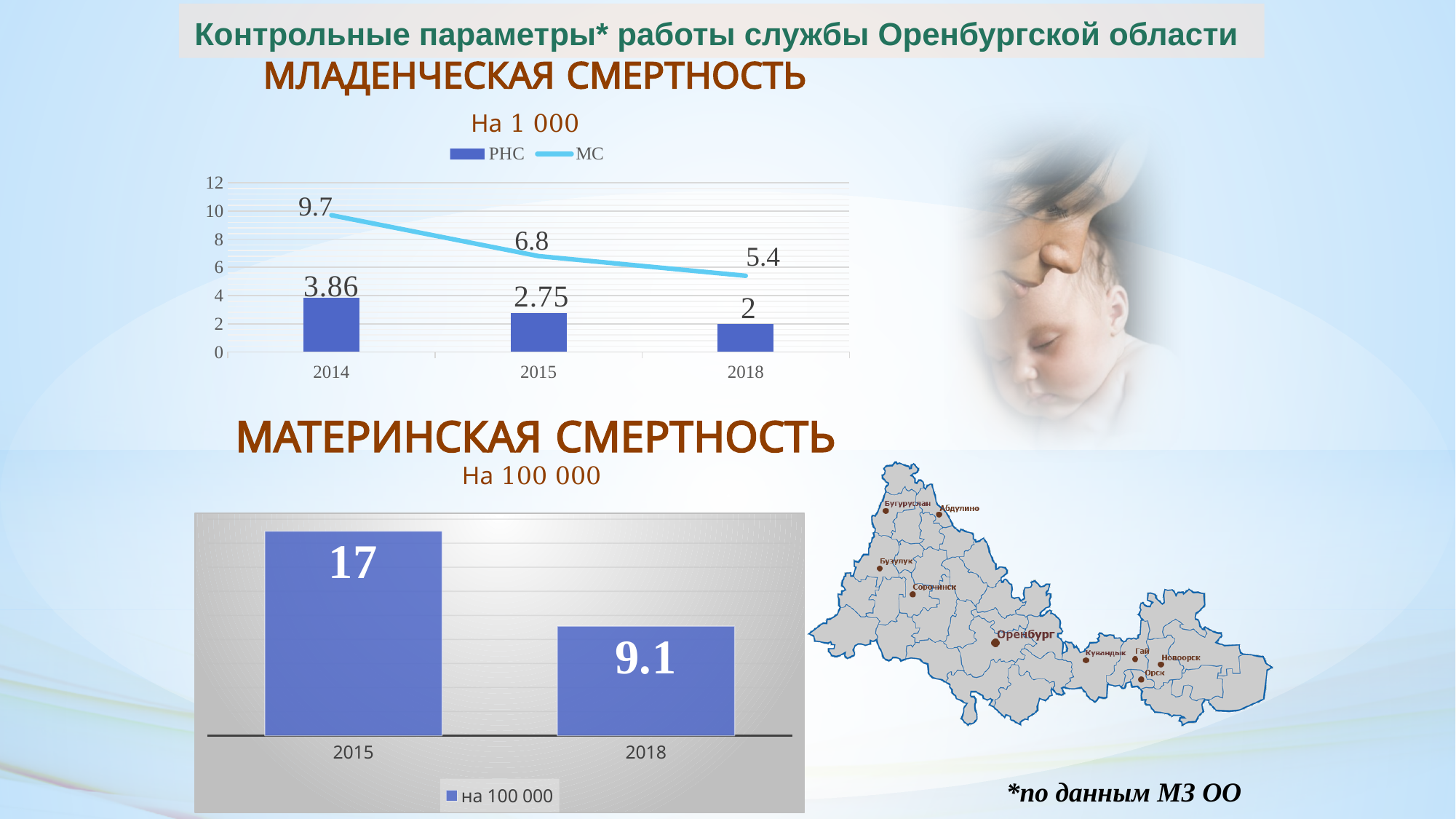
In the МЛАДЕНЧЕСКАЯ СМЕРТНОСТЬ chart, what is the difference between the МС values for 2014 and 2018? 4.3 In the МЛАДЕНЧЕСКАЯ СМЕРТНОСТЬ chart, what is the МС value for 2018? 5.4 What kind of chart is the МАТЕРИНСКАЯ СМЕРТНОСТЬ chart? bar chart In the МЛАДЕНЧЕСКАЯ СМЕРТНОСТЬ chart, how many years are shown on the x axis? 3 In the МАТЕРИНСКАЯ СМЕРТНОСТЬ chart, what is the value for 2018? 9.1 In the МАТЕРИНСКАЯ СМЕРТНОСТЬ chart, what is the difference between the values for 2015 and 2018? 7.9 In the МЛАДЕНЧЕСКАЯ СМЕРТНОСТЬ chart, which year has the highest МС value? 2014 In the МЛАДЕНЧЕСКАЯ СМЕРТНОСТЬ chart, what is the МС value for 2015? 6.8 In the МЛАДЕНЧЕСКАЯ СМЕРТНОСТЬ chart, does the МС line rise or fall from 2014 to 2018? fall In the МЛАДЕНЧЕСКАЯ СМЕРТНОСТЬ chart, what is the РНС value for 2014? 3.86 In the МЛАДЕНЧЕСКАЯ СМЕРТНОСТЬ chart, how many series does the legend list? 2 In the МЛАДЕНЧЕСКАЯ СМЕРТНОСТЬ chart, which year has the lowest РНС value? 2018